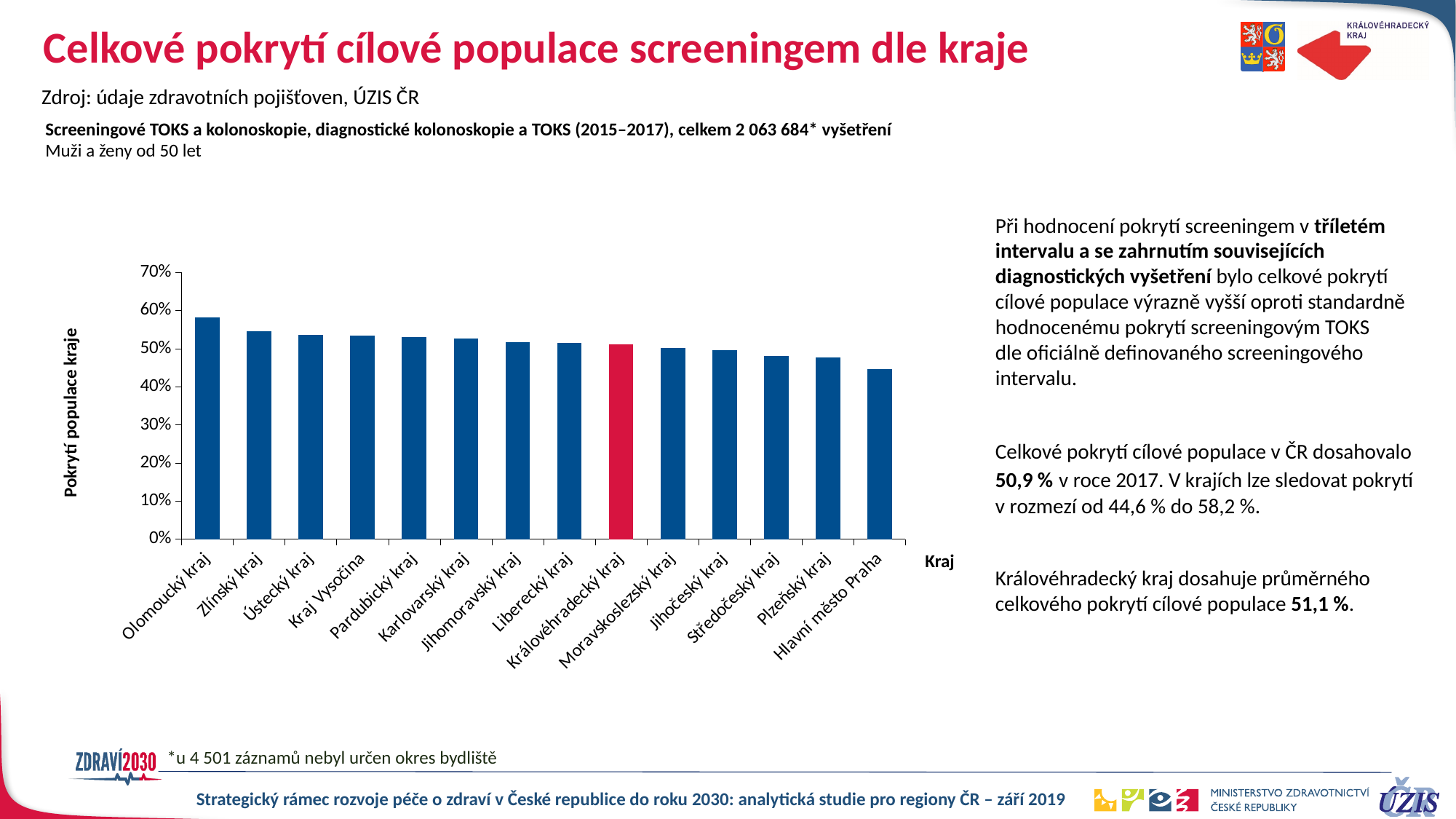
What is the label of the vertical axis of the chart? Pokrytí populace kraje Which region has the highest bar in the chart? Olomoucký kraj Which is larger, the value for Ústecký kraj or the value for Středočeský kraj? Ústecký kraj Which region has the lowest bar in the chart? Hlavní město Praha What kind of chart is shown on the slide? bar chart Is the value for Hlavní město Praha greater or less than 50%? less Is the value for Zlínský kraj greater or less than 60%? less Do the bar values rise or fall from left to right along the x axis? fall Is the value for Plzeňský kraj greater or less than 50%? less How many regions (kraje) are shown on the x axis of the chart? 14 Which region's bar is highlighted in red in the chart? Královéhradecký kraj